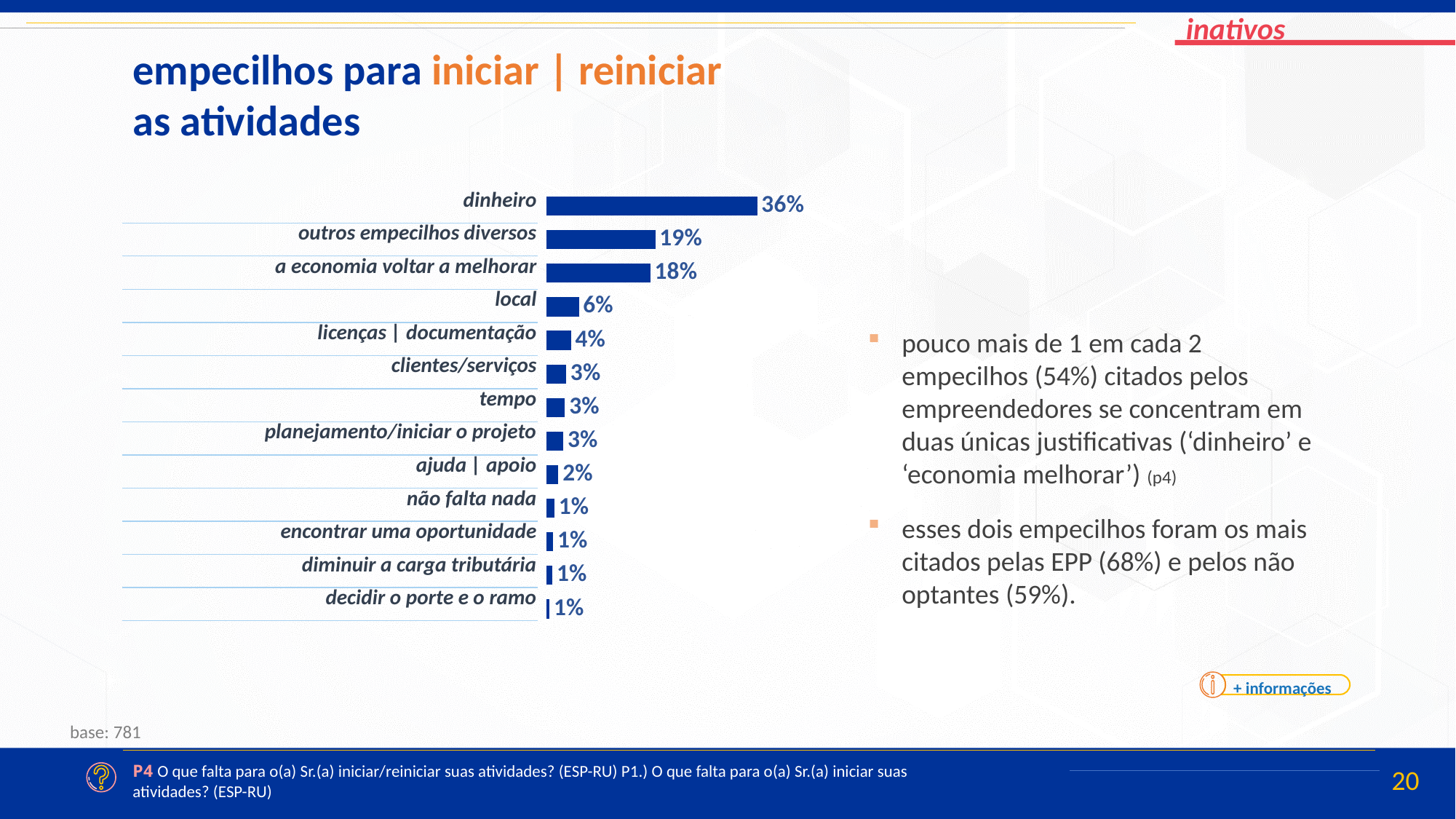
Which is larger, 'local' or 'ajuda | apoio'? local What is the difference between 'outros empecilhos diversos' and 'a economia voltar a melhorar'? 1% Which category has the highest value? dinheiro What kind of chart is shown on the slide? bar chart How many categories are shown in the chart? 13 What is the difference between 'dinheiro' and 'outros empecilhos diversos'? 17% What is the base (number of respondents) shown for the chart? 781 What is the value for 'não falta nada'? 1% What is the value for 'licenças | documentação'? 4% What is the value for 'local'? 6% What is the value for 'dinheiro'? 36% What is the value for 'a economia voltar a melhorar'? 18%